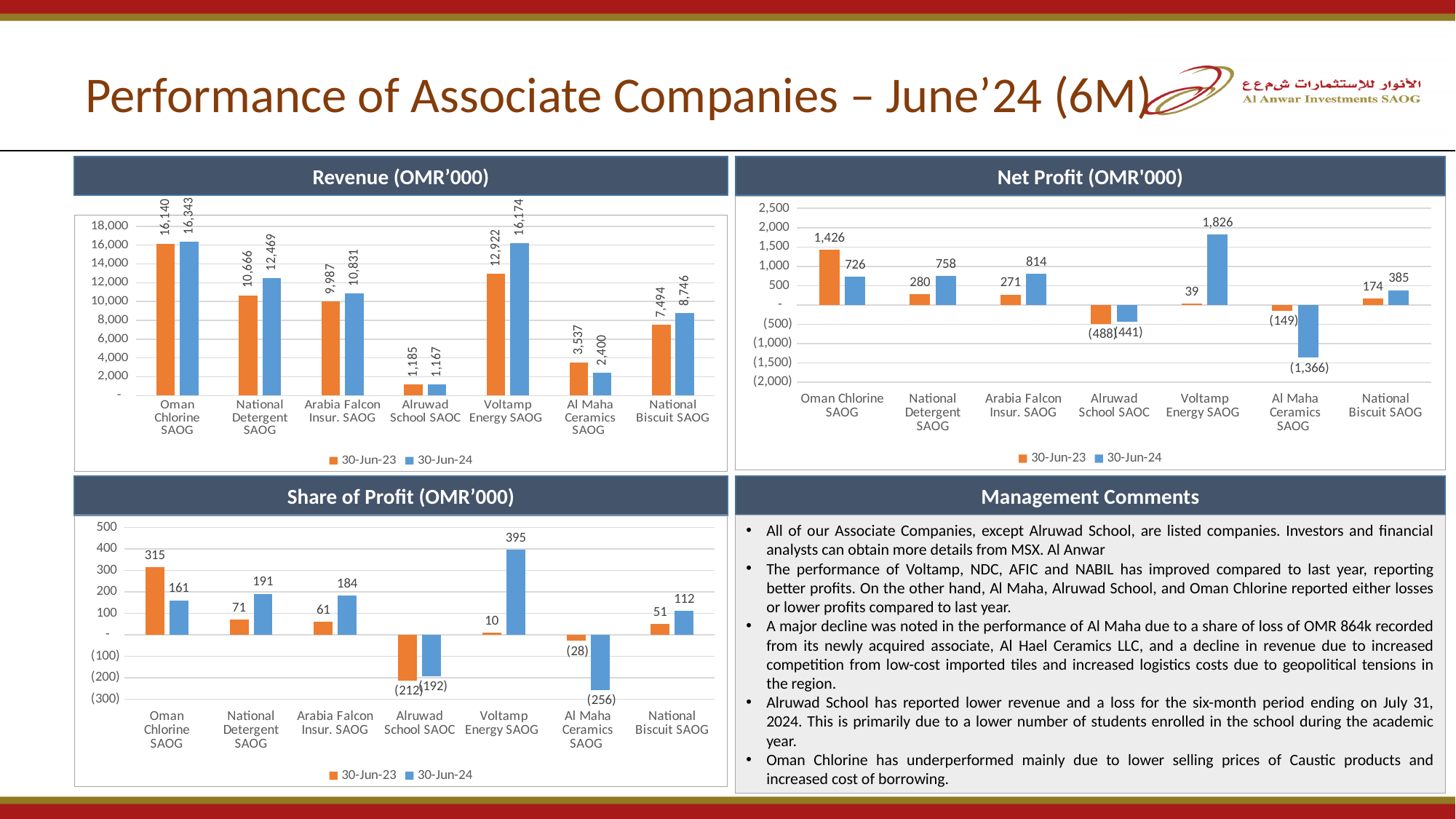
In the Revenue (OMR'000) chart, what is the 30-Jun-24 revenue for Voltamp Energy SAOG? 16,174 How many series does the legend of the Net Profit (OMR'000) chart list? 2 In the Net Profit (OMR'000) chart, which is larger for Oman Chlorine SAOG: the 30-Jun-23 or the 30-Jun-24 value? 30-Jun-23 In the Net Profit (OMR'000) chart, which company has the lowest 30-Jun-24 net profit? Al Maha Ceramics SAOG In the Share of Profit (OMR'000) chart, which company has the highest 30-Jun-24 share of profit? Voltamp Energy SAOG How many companies are shown on the x axis of the Share of Profit (OMR'000) chart? 7 In the Net Profit (OMR'000) chart, what is the 30-Jun-24 net profit for Voltamp Energy SAOG? 1,826 In the Share of Profit (OMR'000) chart, what is the 30-Jun-24 value for Arabia Falcon Insur. SAOG? 184 In the Revenue (OMR'000) chart, which company has the highest 30-Jun-24 revenue? Oman Chlorine SAOG In the Revenue (OMR'000) chart, what is the 30-Jun-23 revenue for Al Maha Ceramics SAOG? 3,537 In the Net Profit (OMR'000) chart, what is the 30-Jun-24 value for Al Maha Ceramics SAOG? (1,366) In the Revenue (OMR'000) chart, what is the difference between the 30-Jun-24 and 30-Jun-23 revenue for National Detergent SAOG? 1,803